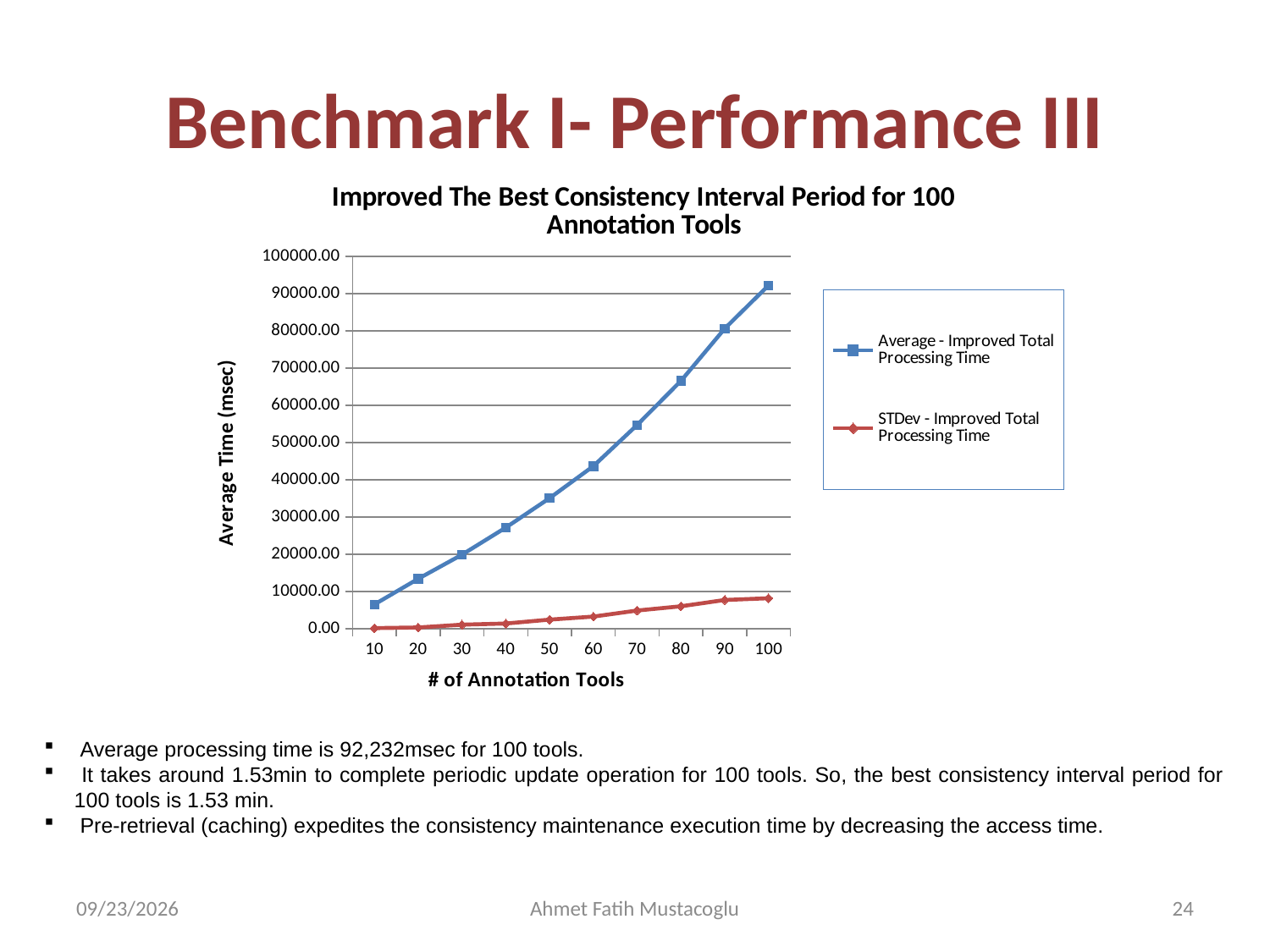
Is the STDev - Improved Total Processing Time for 100 tools greater or less than 10000.00? less Is the Average - Improved Total Processing Time for 100 tools greater or less than 90000.00? greater At which number of annotation tools is the Average - Improved Total Processing Time highest? 100 At 100 annotation tools, which series has the larger value: Average - Improved Total Processing Time or STDev - Improved Total Processing Time? Average - Improved Total Processing Time Does the Average - Improved Total Processing Time rise or fall as the number of annotation tools increases? rises At which number of annotation tools is the Average - Improved Total Processing Time lowest? 10 How many points along the x axis (# of Annotation Tools) are plotted for each series? 10 What is the title of the chart? Improved The Best Consistency Interval Period for 100 Annotation Tools How many series does the legend list? 2 Is the Average - Improved Total Processing Time for 80 tools greater or less than 60000.00? greater What kind of chart is shown on the slide? line chart